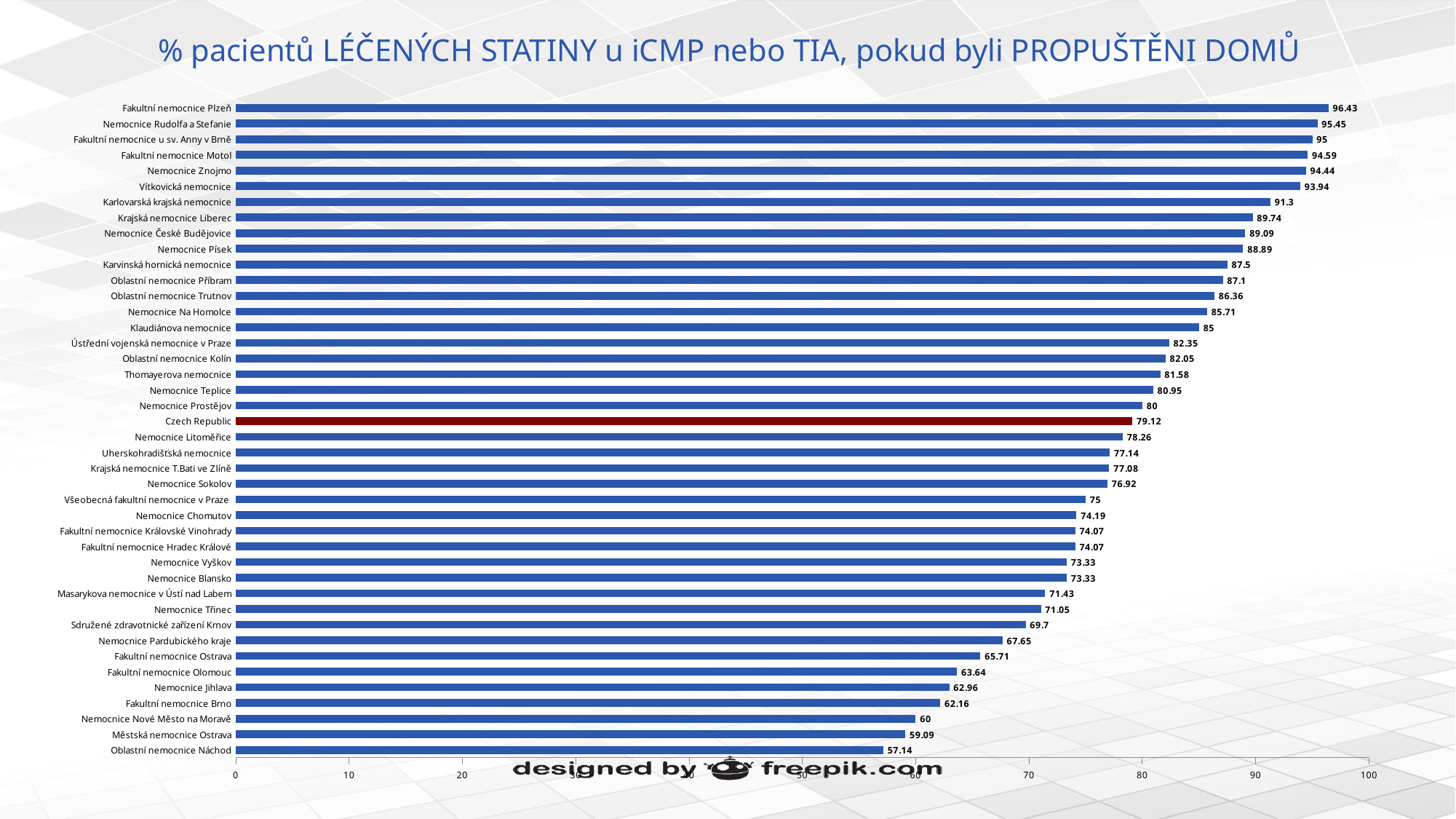
How many hospitals/categories are shown in the chart? 42 What is the value for Czech Republic? 79.12 What is the difference between the values for Fakultní nemocnice Plzeň and Oblastní nemocnice Náchod? 39.29 What is the value for Fakultní nemocnice Motol? 94.59 What kind of chart is shown on the slide? bar chart Is the value for Fakultní nemocnice Brno greater or less than 70? less What is the value for Nemocnice Jihlava? 62.96 Which is larger, the value for Nemocnice Písek or the value for Nemocnice Sokolov? Nemocnice Písek Which hospital has the lowest value? Oblastní nemocnice Náchod What is the difference between the values for Nemocnice Prostějov and Czech Republic? 0.88 Which bar is shown in a different colour (dark red) from the others? Czech Republic Which hospital has the highest value? Fakultní nemocnice Plzeň